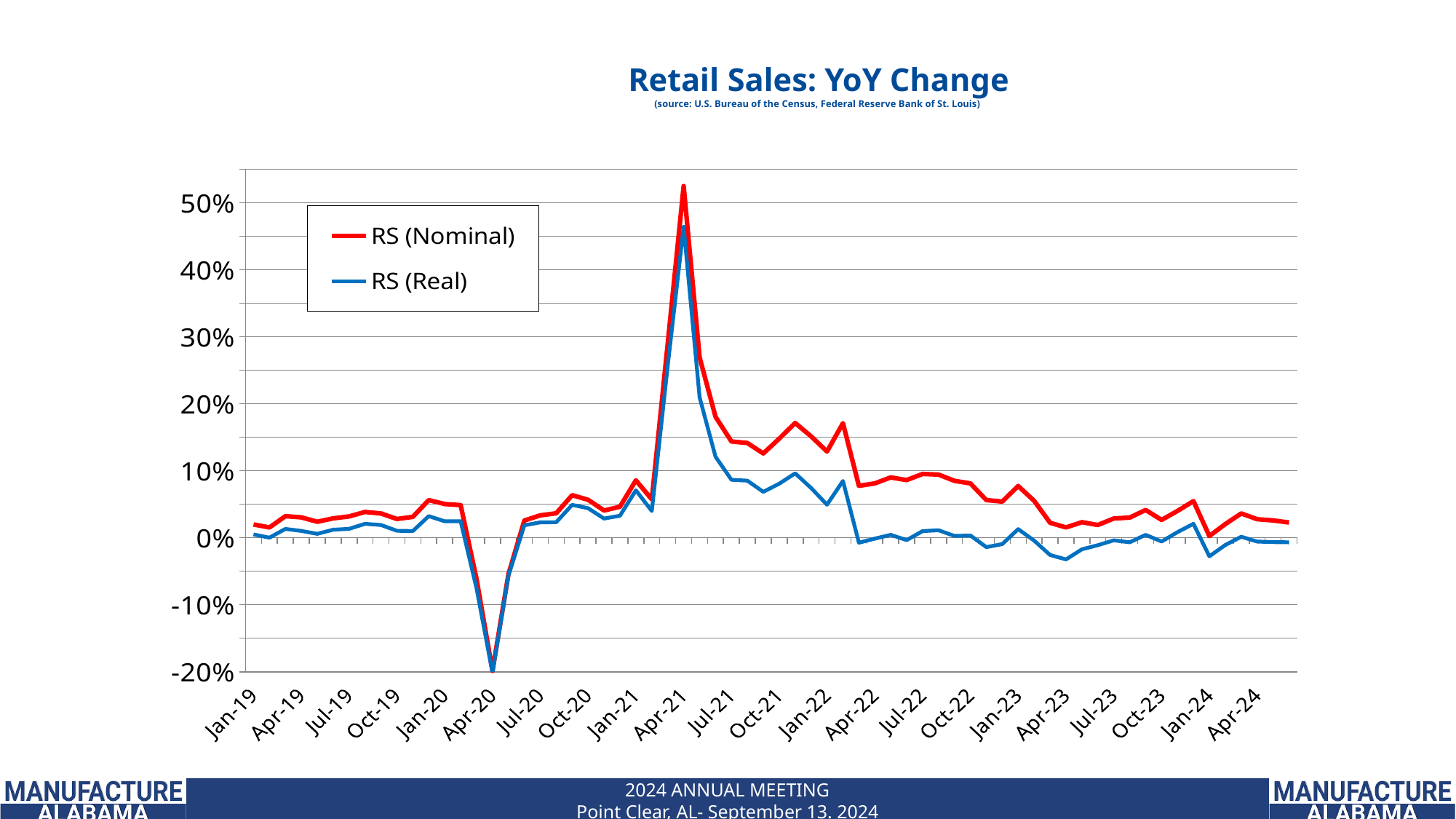
At which x-axis label does the RS (Real) series reach its lowest value? Apr-20 At Apr-22, which series has the larger value, RS (Nominal) or RS (Real)? RS (Nominal) What kind of chart is shown on the slide? line chart How many series does the legend list? 2 Is the value for RS (Nominal) at Apr-21 greater or less than 40%? greater Between Apr-21 and Jul-21, does the RS (Nominal) series rise or fall? fall Is the value for RS (Nominal) at Apr-20 greater or less than -10%? less What is the title of the chart? Retail Sales: YoY Change Is the value for RS (Nominal) at Jan-22 greater or less than 10%? greater Which colour is used for the RS (Real) series? blue At which x-axis label does the RS (Nominal) series reach its highest value? Apr-21